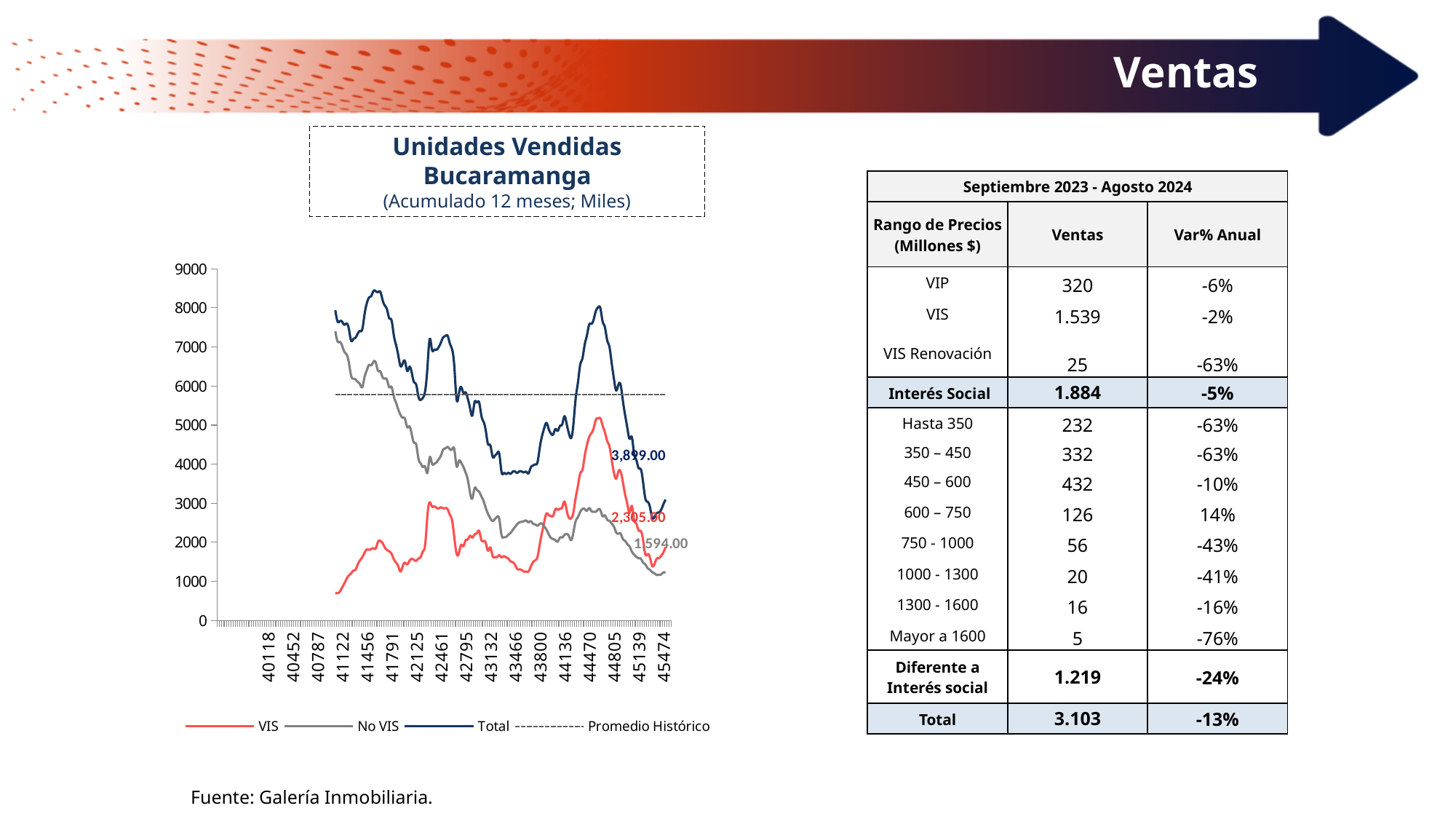
In the 'Unidades Vendidas Bucaramanga' chart, which labelled value is larger, VIS or No VIS? VIS In the 'Unidades Vendidas Bucaramanga' chart, which legend entry is drawn as a dashed line? Promedio Histórico What kind of chart is shown under the title 'Unidades Vendidas Bucaramanga'? Line chart In the 'Unidades Vendidas Bucaramanga' chart, what is the labelled value for the Total series? 3,899.00 In the 'Unidades Vendidas Bucaramanga' chart, which series has the highest labelled value? Total In the 'Unidades Vendidas Bucaramanga' chart, is the Promedio Histórico line greater or less than 5000? greater In the 'Unidades Vendidas Bucaramanga' chart, which series has the lowest labelled value? No VIS How many series does the legend of the 'Unidades Vendidas Bucaramanga' chart list? 4 In the 'Unidades Vendidas Bucaramanga' chart, what is the labelled value for the No VIS series? 1,594.00 In the 'Unidades Vendidas Bucaramanga' chart, what is the labelled value for the VIS series? 2,305.00 In the 'Unidades Vendidas Bucaramanga' chart, what is the difference between the labelled Total value and the labelled VIS value? 1,594.00 In the 'Unidades Vendidas Bucaramanga' chart, does the Total series end higher or lower than where it starts on the left? lower